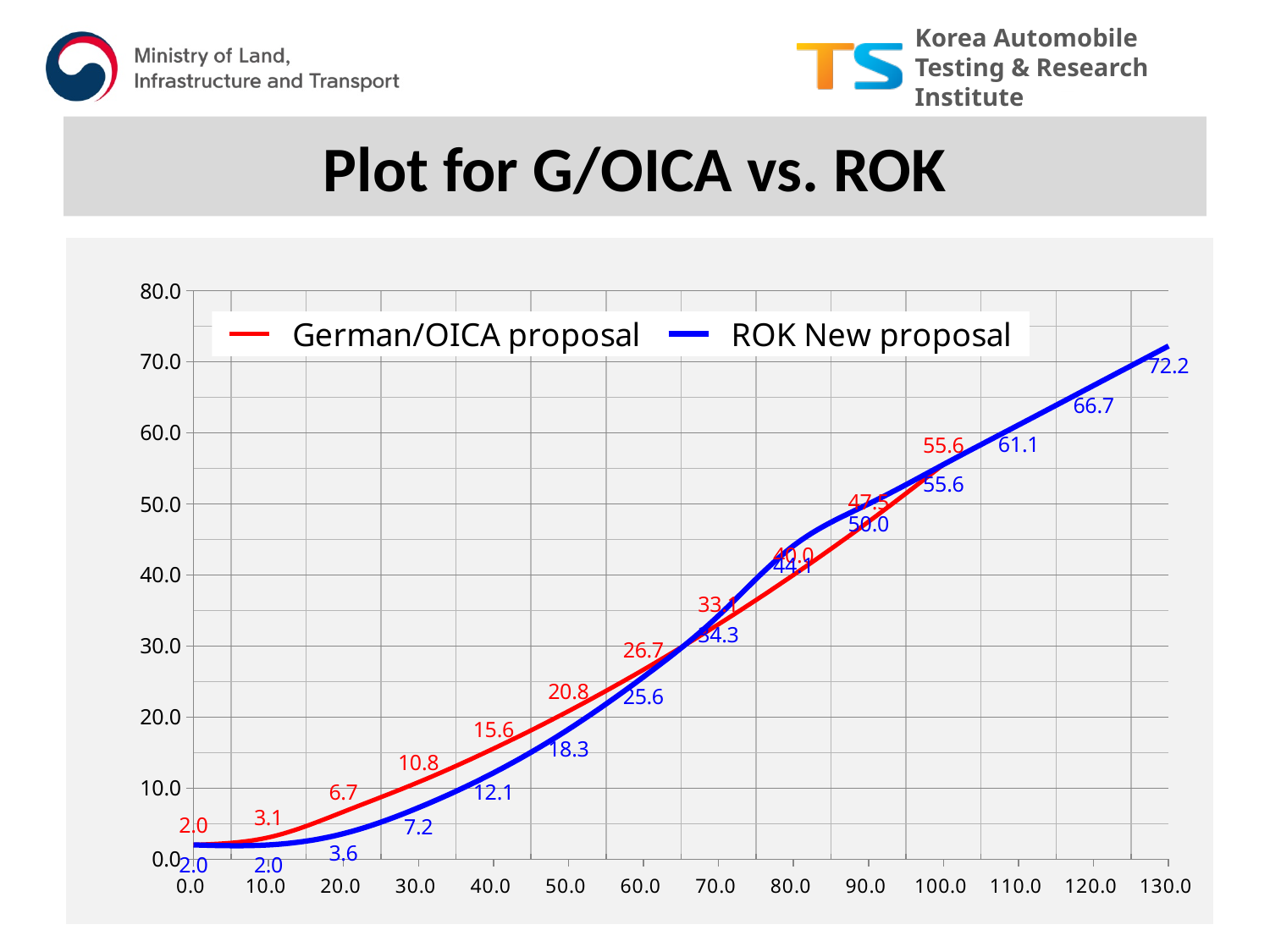
What is the highest labelled value of the ROK New proposal series? 72.2 At x = 80.0, which series has the larger value, German/OICA proposal or ROK New proposal? ROK New proposal What is the value of the ROK New proposal at x = 130.0? 72.2 What is the value of the German/OICA proposal at x = 50.0? 20.8 How many series does the legend list? 2 What is the difference between the German/OICA proposal (15.6) and the ROK New proposal (12.1) at x = 40.0? 3.5 Do the values of the ROK New proposal rise or fall as x increases from 20.0 to 130.0? rise What is the value of the ROK New proposal at x = 40.0? 12.1 What kind of chart is shown on the slide? line chart What is the value of the German/OICA proposal at x = 90.0? 47.5 At x = 30.0, which series has the larger value, German/OICA proposal or ROK New proposal? German/OICA proposal Which series is drawn in blue? ROK New proposal